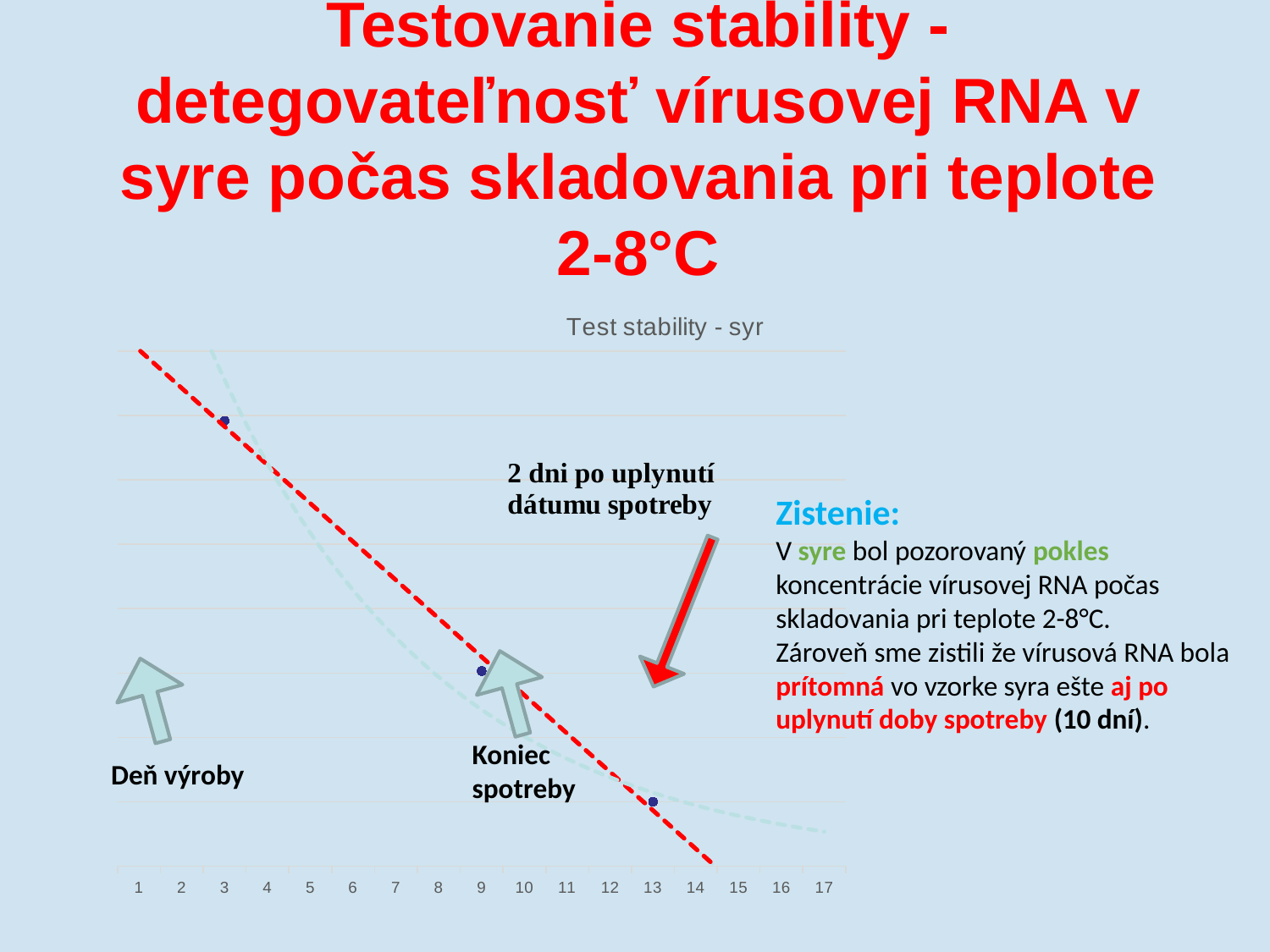
What kind of chart is shown on the slide? line chart Which plotted point is higher, the one at x = 9 or the one at x = 13? x = 9 Which plotted point is higher, the one at x = 3 or the one at x = 13? x = 3 How many tick labels are shown on the x axis? 17 What is the last tick label on the x axis? 17 At which x-axis value is the lowest plotted point? 13 Do the plotted values rise or fall as the x axis increases? fall What is the title of the chart? Test stability - syr How many data points are plotted on the chart? 3 Does the red dashed trend line slope upward or downward from left to right? downward At which x-axis value is the highest plotted point? 3